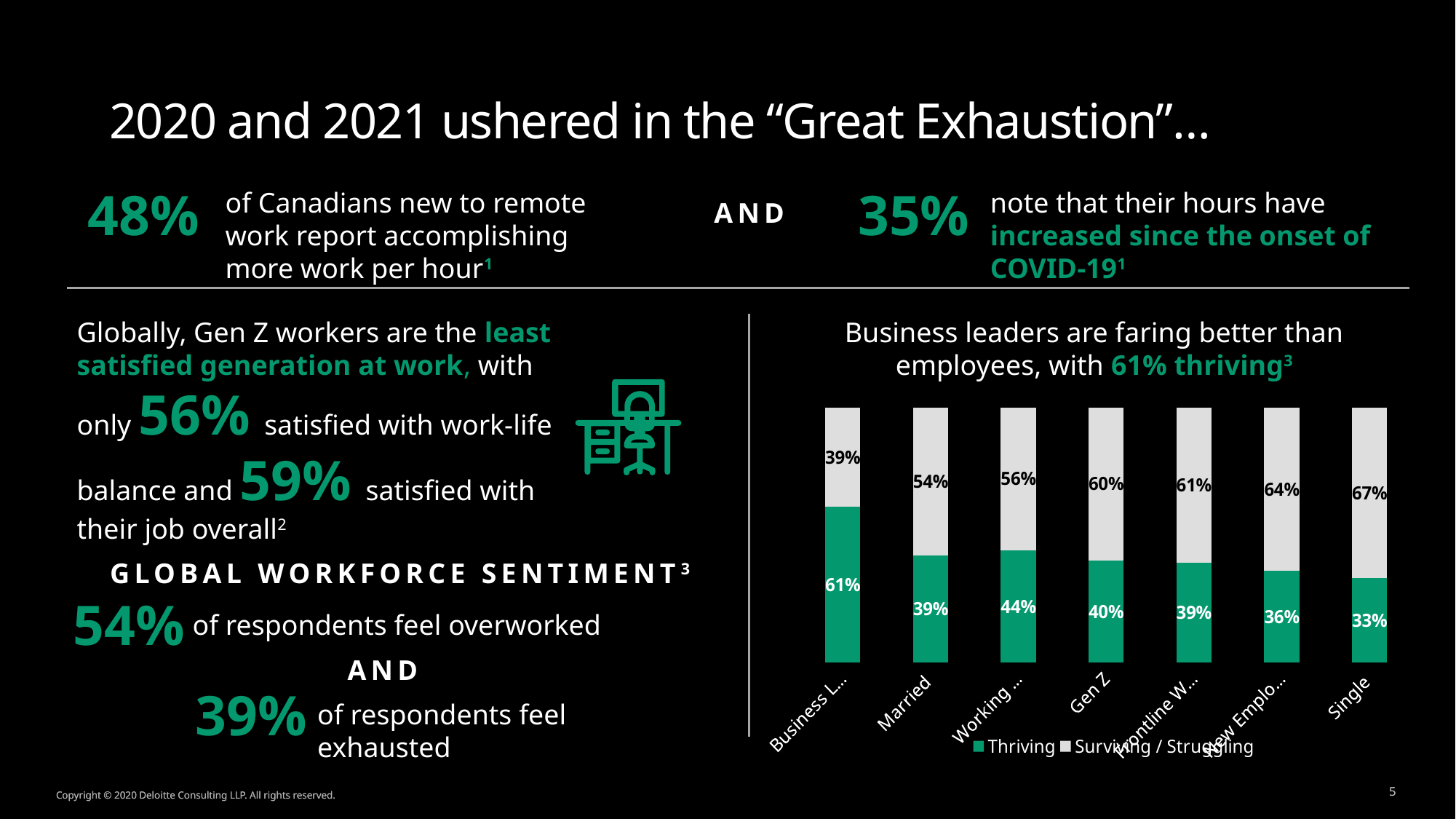
Which category has the highest Surviving / Struggling value? Single What is the Surviving / Struggling value for Gen Z? 60% How many series does the chart legend list? 2 Which has a larger Thriving value, Married or Gen Z? Gen Z How many categories are shown on the x axis of the chart? 7 Do the Surviving / Struggling values rise or fall from left to right across the categories? Rise What is the difference between the Thriving values for Gen Z and Single? 7% What kind of chart is shown on the slide? Stacked bar chart What is the Thriving value for Gen Z? 40% What is the Surviving / Struggling value for Single? 67% Which category has the lowest Thriving value? Single What is the Thriving value for Married? 39%